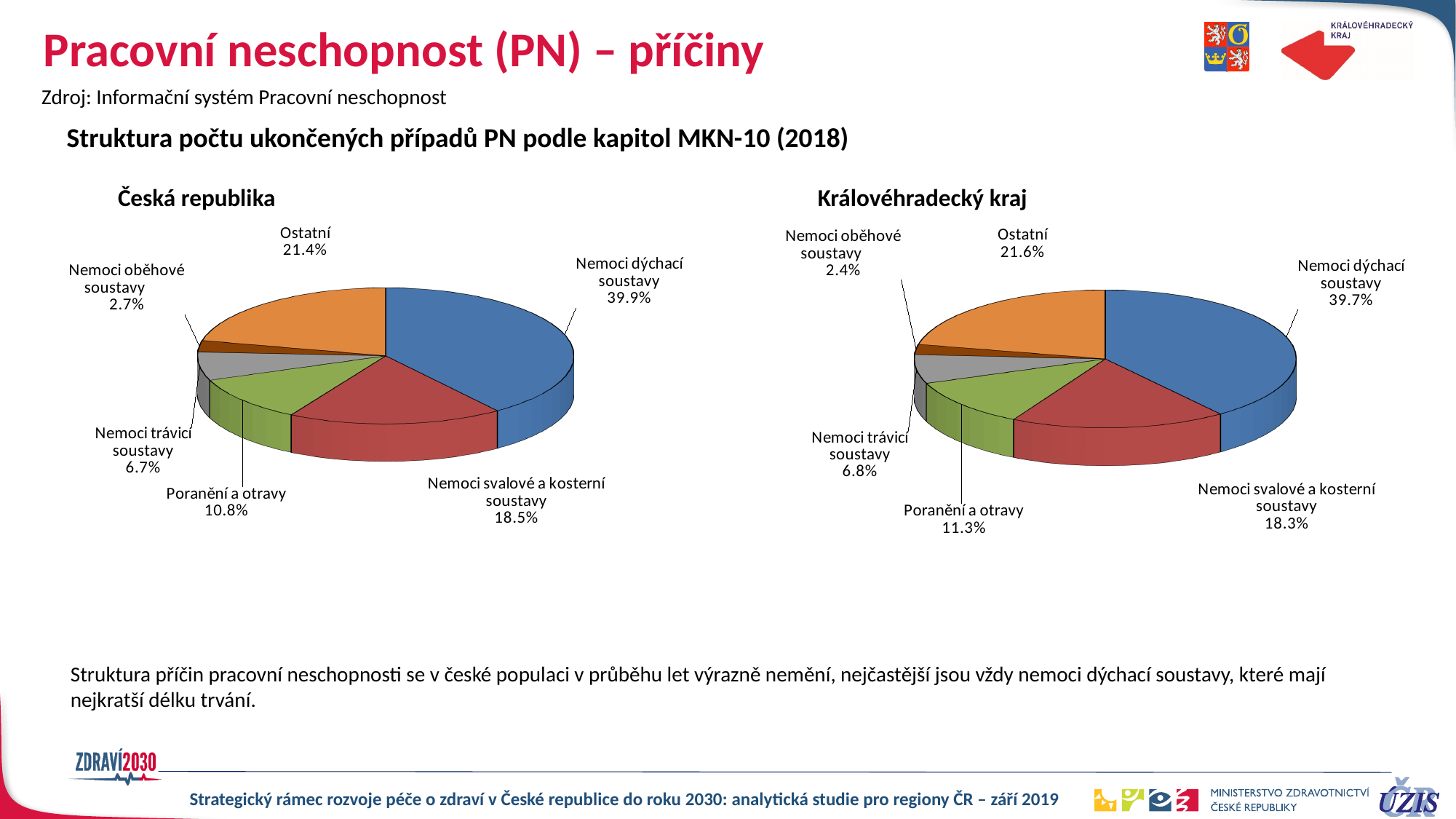
In the Česká republika chart, what share is Nemoci dýchací soustavy? 39.9% In the Královéhradecký kraj chart, what is the difference between Nemoci dýchací soustavy and Ostatní? 18.1% In the Česká republika chart, which is larger: Nemoci trávicí soustavy or Nemoci oběhové soustavy? Nemoci trávicí soustavy In the Královéhradecký kraj chart, what share is Poranění a otravy? 11.3% In the Česká republika chart, what is the difference between Ostatní and Nemoci svalové a kosterní soustavy? 2.9% How many categories does the Královéhradecký kraj chart show? 6 What type of chart is the Česká republika chart? Pie chart Which is larger: Poranění a otravy in the Česká republika chart or in the Královéhradecký kraj chart? Královéhradecký kraj What is the title of the chart on the right? Královéhradecký kraj In the Královéhradecký kraj chart, which category has the smallest share? Nemoci oběhové soustavy In the Královéhradecký kraj chart, what share is Nemoci oběhové soustavy? 2.4% In the Česká republika chart, which category has the largest share? Nemoci dýchací soustavy